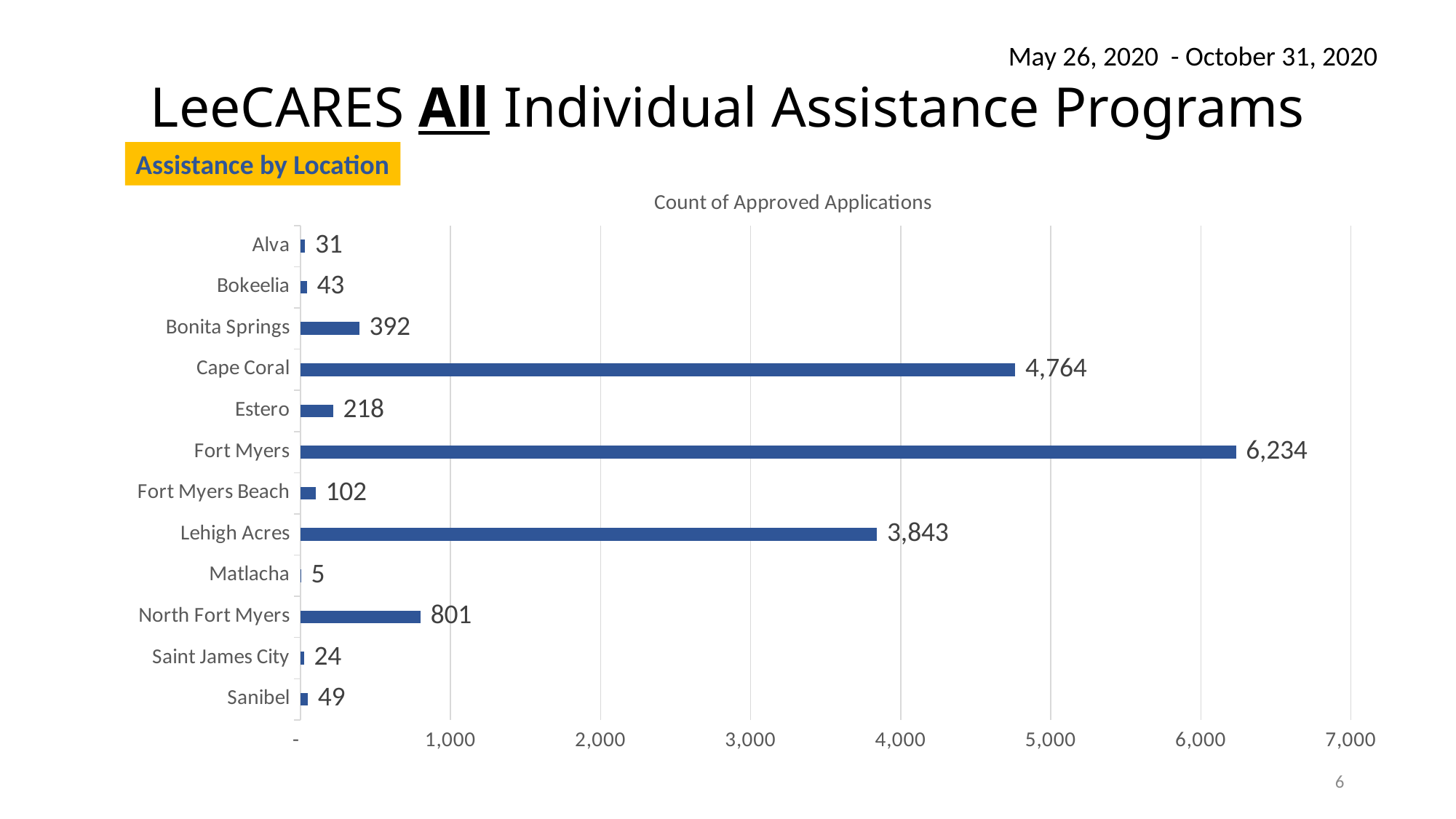
Which has more approved applications, Sanibel or Bokeelia? Sanibel What is the difference in approved applications between Fort Myers and Cape Coral? 1,470 How many locations are shown in the chart? 12 What is the count of approved applications for Cape Coral? 4,764 Which location has the highest count of approved applications? Fort Myers Is the value for Lehigh Acres greater or less than 4,000? less What kind of chart is shown on the slide? bar chart Which location has the lowest count of approved applications? Matlacha What is the difference in approved applications between Bonita Springs and Estero? 174 What is the title of the chart? Count of Approved Applications What is the count of approved applications for Lehigh Acres? 3,843 What is the count of approved applications for North Fort Myers? 801